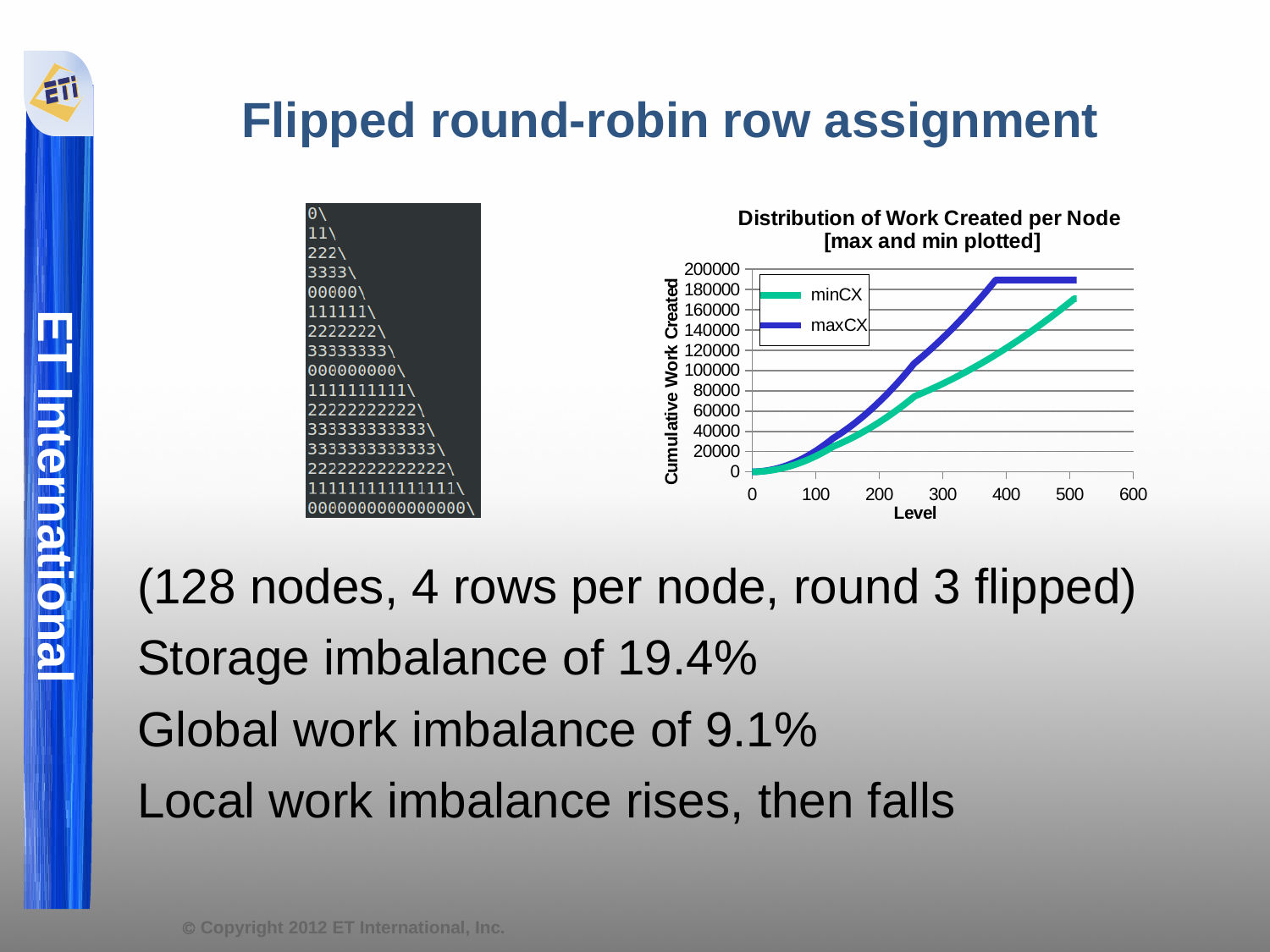
Is the value of maxCX at Level 500 greater or less than 180000? greater At Level 500, which series has the higher Cumulative Work Created, minCX or maxCX? maxCX Do the values of the maxCX series rise or fall as Level increases? rise What are the two series named in the chart legend? minCX and maxCX Is the value of maxCX at Level 400 greater or less than 160000? greater Do the values of the minCX series rise or fall as Level increases? rise Is the value of minCX at Level 500 greater or less than 160000? greater What is the title of the chart? Distribution of Work Created per Node [max and min plotted] How many series does the legend of the chart list? 2 At Level 300, which series has the higher Cumulative Work Created, minCX or maxCX? maxCX What kind of chart is shown on the slide? line chart